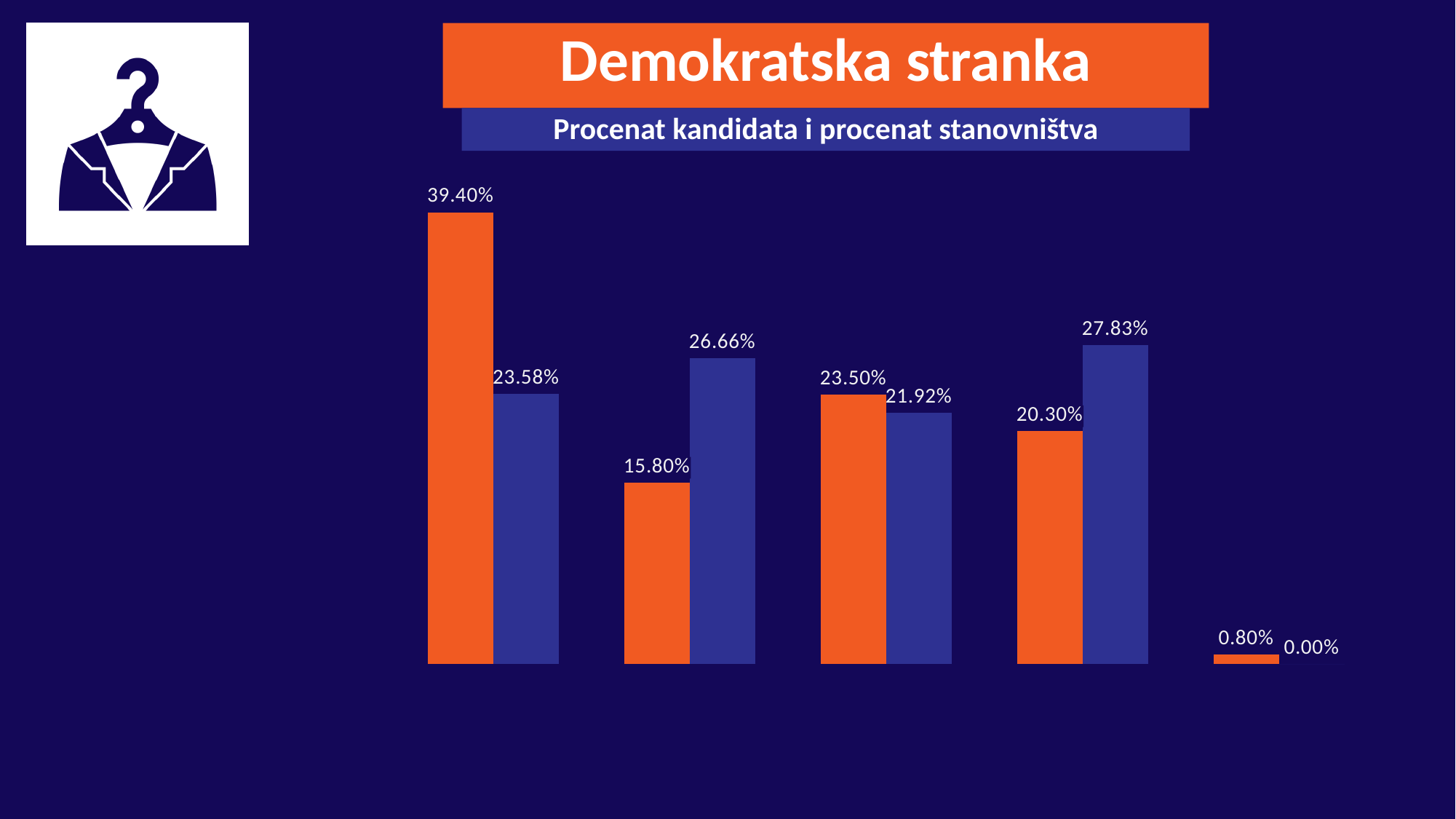
What is the value of the orange bar in the fourth group from the left? 20.30% What is the title shown above the chart? Demokratska stranka What is the difference between the orange and blue bars in the first (leftmost) group? 15.82% What is the value of the blue bar in the fifth (rightmost) group? 0.00% What is the lowest value among the orange bars? 0.80% How many groups of bars does the chart contain? 5 What is the highest value among the blue bars? 27.83% What is the value of the blue bar in the first (leftmost) group? 23.58% What is the difference between the blue and orange bars in the fourth group from the left? 7.53% In the second group from the left, which bar is larger, the orange or the blue one? Blue What is the value of the orange bar in the first (leftmost) group? 39.40% What kind of chart is shown on the slide? Bar chart